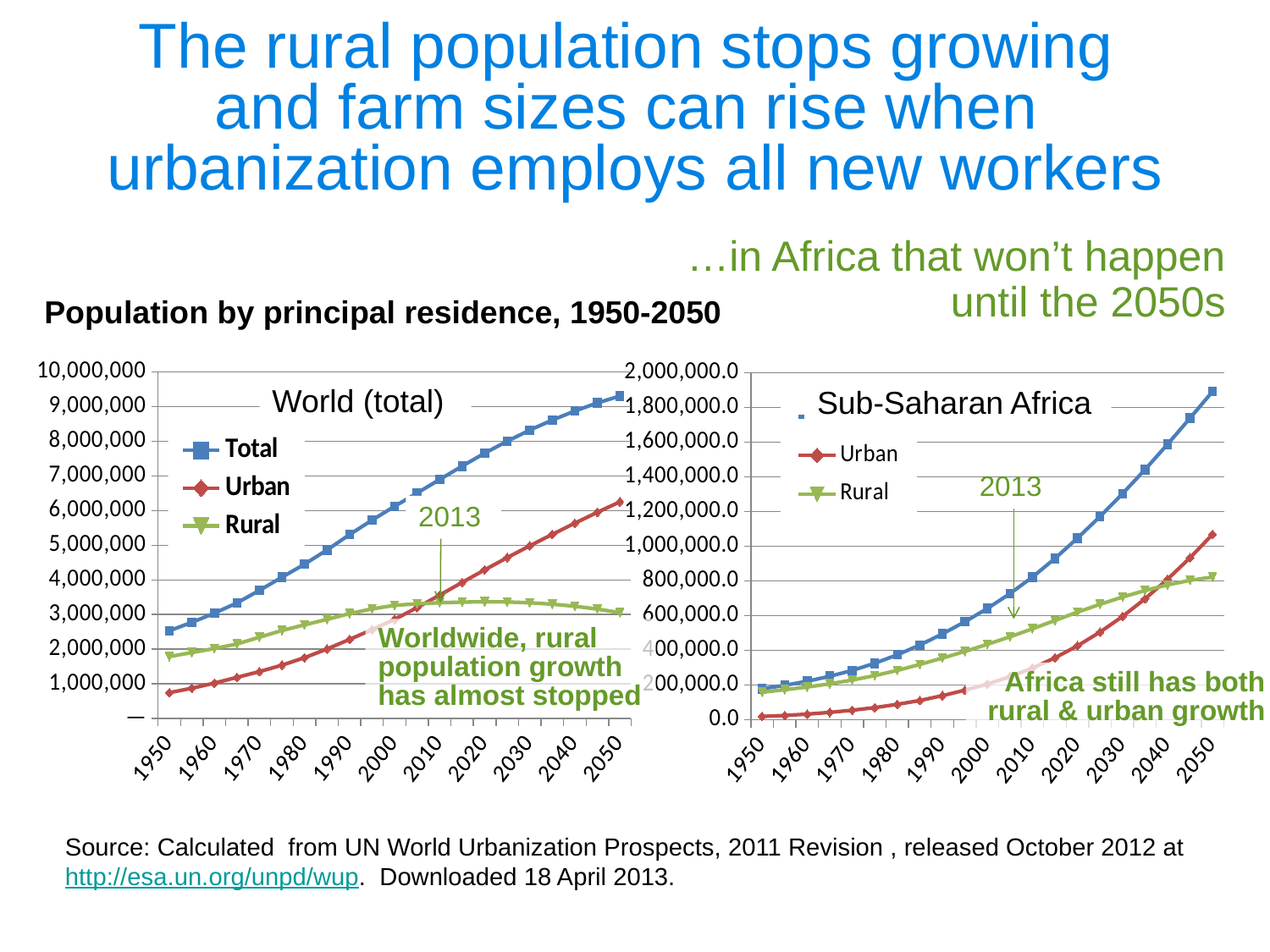
How many year labels are shown on the x axis of the Sub-Saharan Africa chart? 11 In the Sub-Saharan Africa chart, which series is higher in 1950, Urban or Rural? Rural In the World (total) chart, which series has the highest value in 2050? Total In the World (total) chart, is the Urban value for 1950 greater or less than 1,000,000? less What is the title printed above the two charts? Population by principal residence, 1950-2050 In the Sub-Saharan Africa chart, is the Urban value for 2050 greater or less than 1,000,000.0? greater How many series does the legend of the World (total) chart list? 3 What kind of chart is the World (total) chart? line chart In the World (total) chart, is the Total value for 2050 greater or less than 9,000,000? greater In the World (total) chart, which series is higher in 2050, Urban or Rural? Urban In the World (total) chart, does the Total series rise or fall from 1950 to 2050? rise